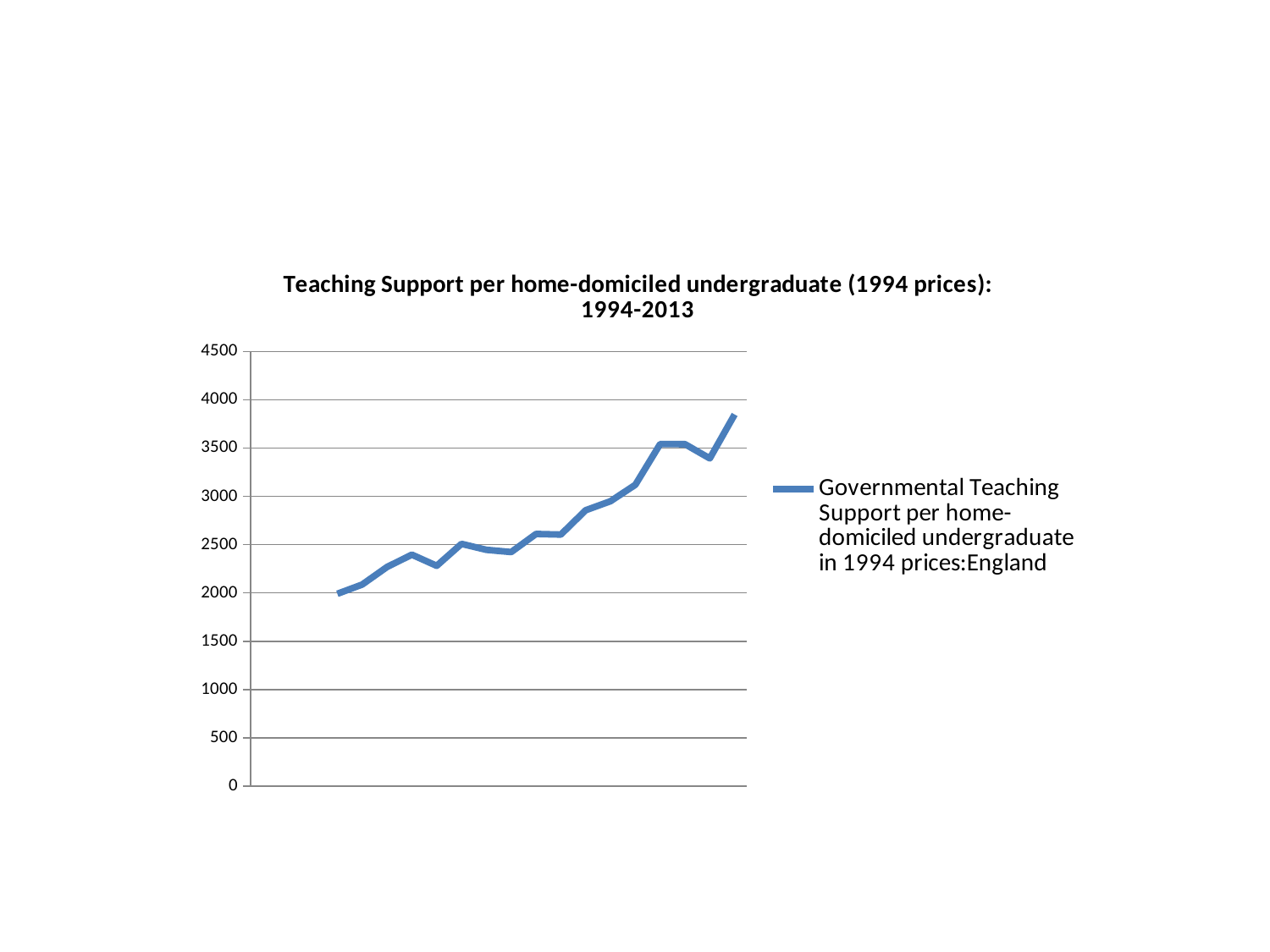
How many series does the legend list? 1 What is the legend entry for the plotted line? Governmental Teaching Support per home-domiciled undergraduate in 1994 prices:England Is the highest value on the line greater or less than 3500? greater Is the highest value on the line greater or less than 4000? less What is the title of the chart? Teaching Support per home-domiciled undergraduate (1994 prices): 1994-2013 Overall, do the values rise or fall from left to right along the x axis? rise Is the lowest value on the line greater or less than 2500? less What kind of chart is shown on the slide? line chart Which is larger, the first point on the line or the last point on the line? the last point